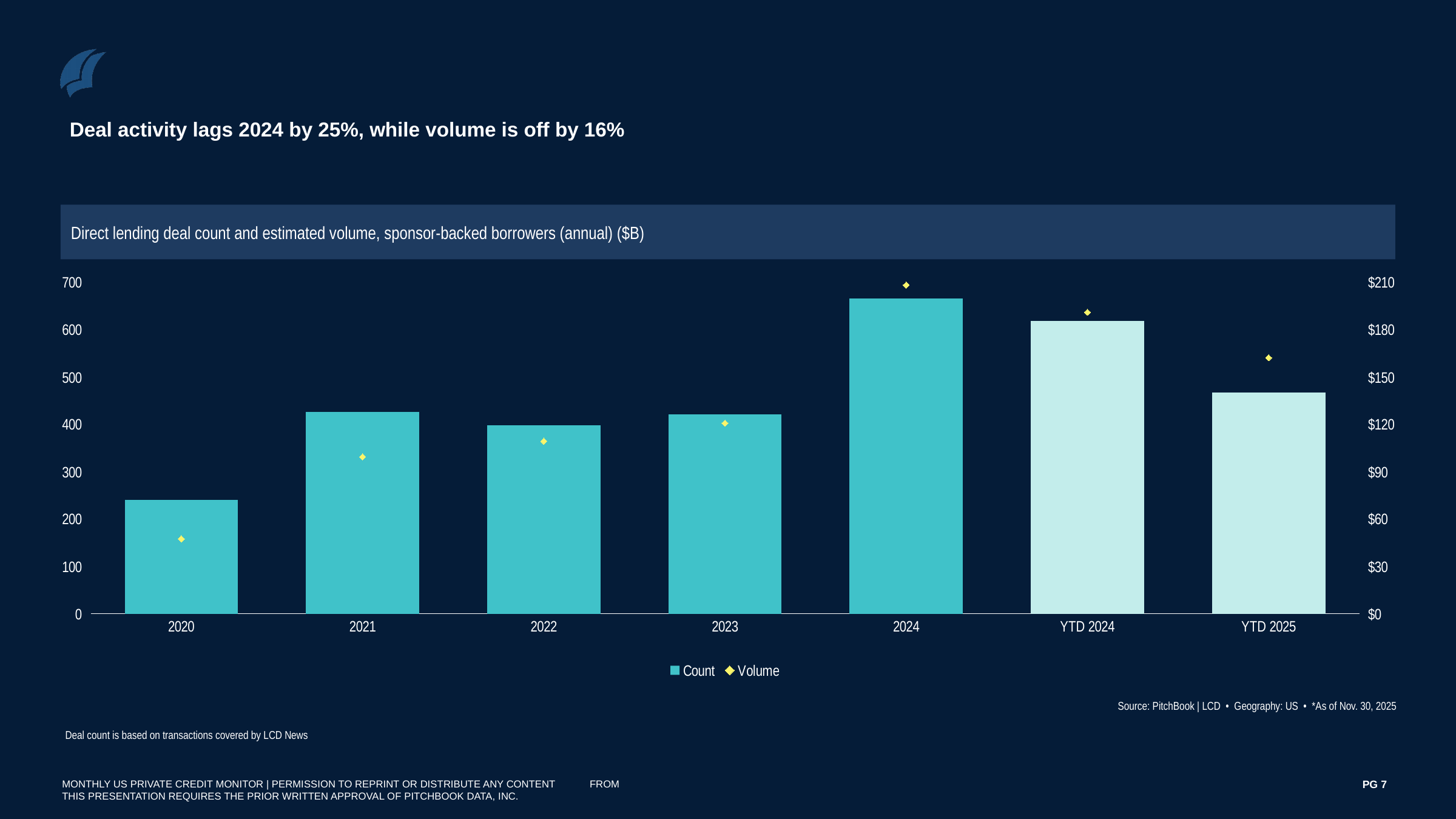
Is the deal count for 2020 greater or less than 300? less What is the title of the chart? Direct lending deal count and estimated volume, sponsor-backed borrowers (annual) ($B) Is the deal count for 2024 greater or less than 600? greater Which category has the lowest deal count? 2020 Which category has the highest volume? 2024 How many series does the legend list? 2 Which category has the highest deal count? 2024 How many categories are shown along the x axis? 7 Which has the larger deal count, YTD 2024 or YTD 2025? YTD 2024 Which category has the lowest volume? 2020 Is the volume for YTD 2025 greater or less than $150? greater What kind of chart is shown on the slide? Bar chart with a line/marker series (combination chart)